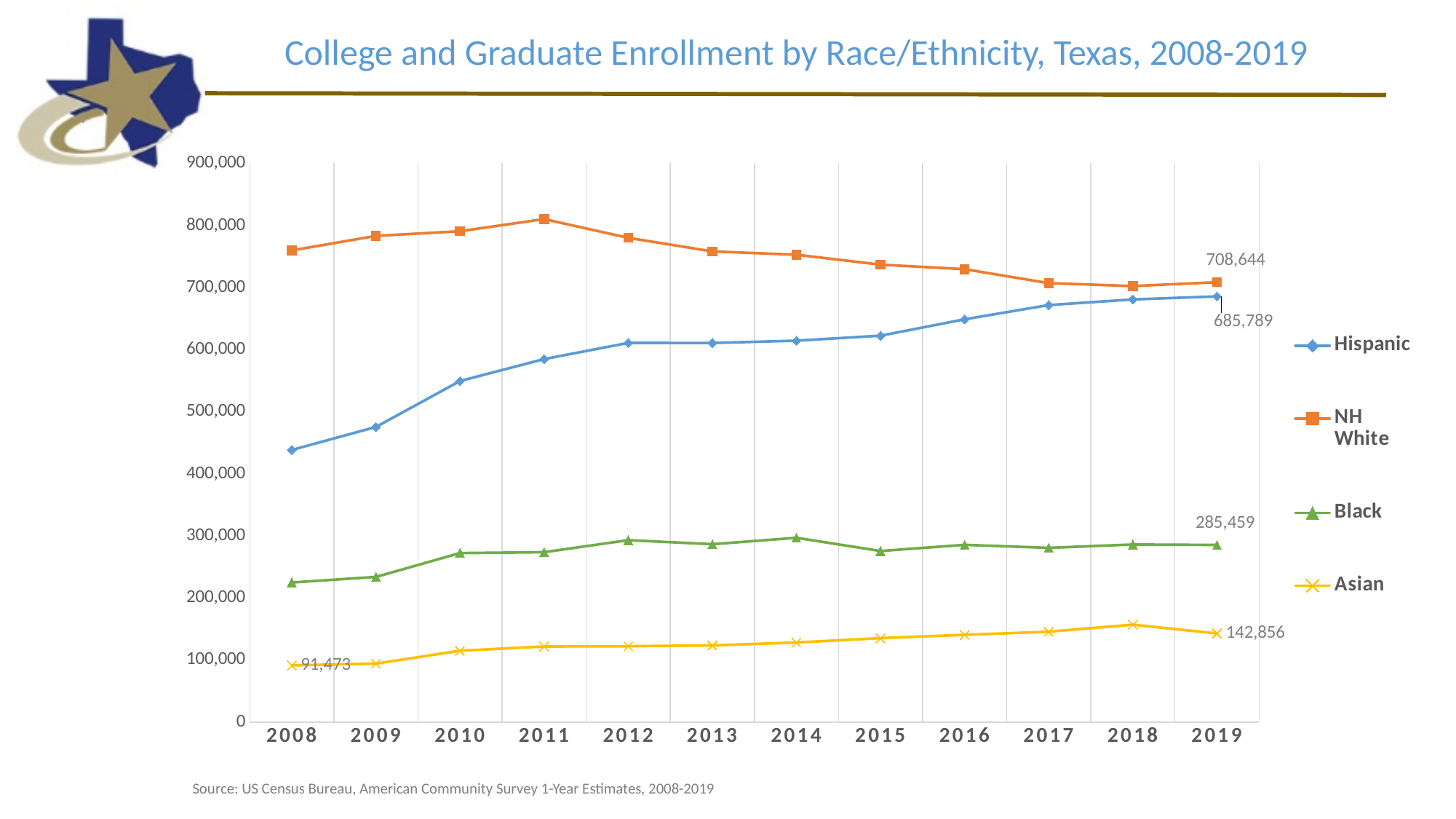
Is the Hispanic enrollment value for 2008 greater or less than 500,000? less Does Hispanic enrollment rise or fall from 2008 to 2019? rise What is the difference between the NH White and Hispanic enrollment values in 2019? 22,855 How many years are shown on the x axis? 12 What is the Black enrollment value in 2019? 285,459 What is the Asian enrollment value in 2008? 91,473 What type of chart is shown on the slide? line chart How many series does the legend list? 4 Which series has the lowest enrollment in 2019? Asian By how much did Asian enrollment increase from 2008 to 2019? 51,383 What is the NH White enrollment value in 2019? 708,644 What is the Hispanic enrollment value in 2019? 685,789